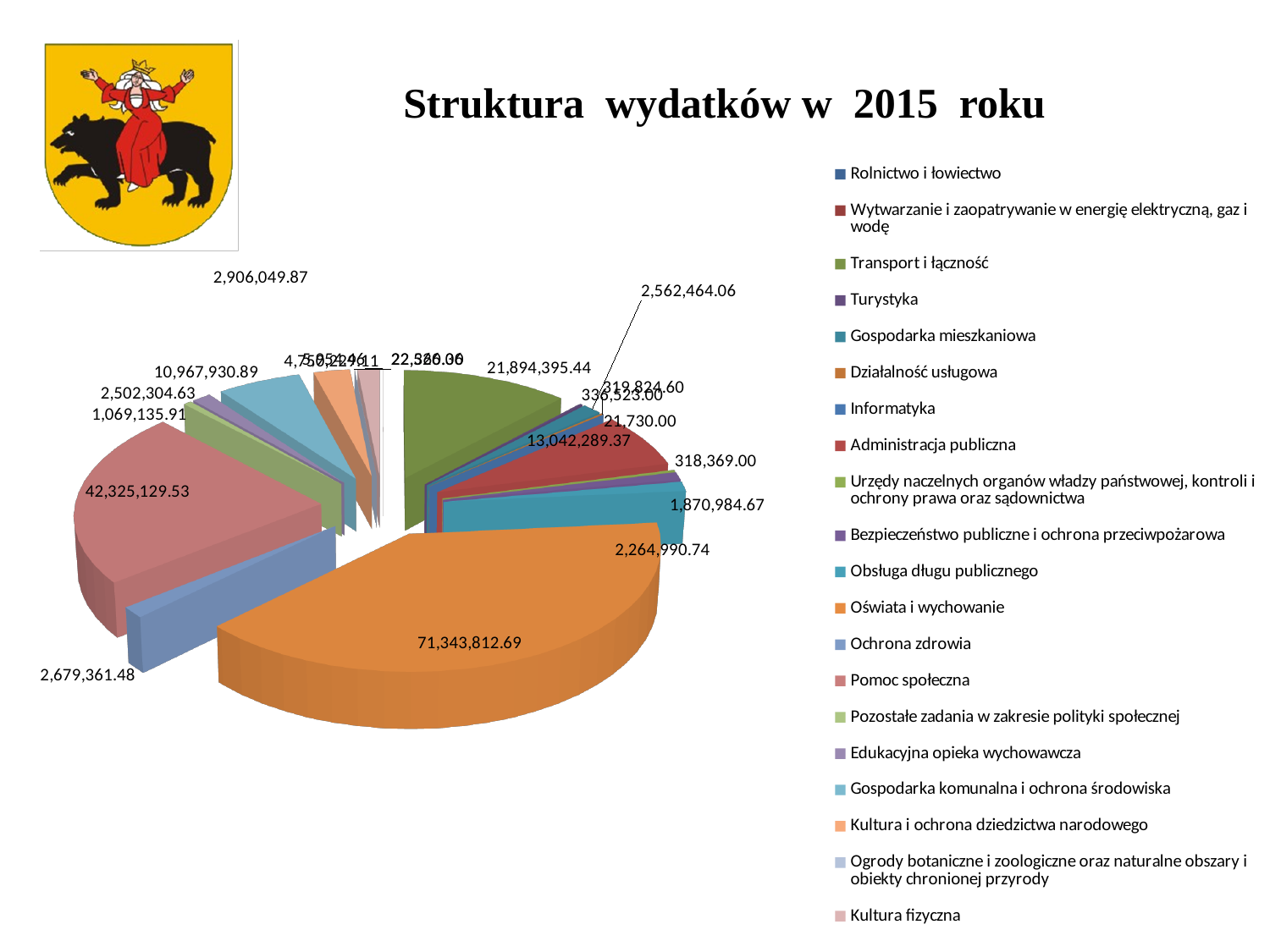
What is the difference between the values for Oświata i wychowanie and Pomoc społeczna? 29,018,683.16 What is the value shown for Administracja publiczna? 13,042,289.37 Which is larger, the slice for Oświata i wychowanie or the slice for Pomoc społeczna? Oświata i wychowanie What is the value of the largest slice of the pie? 71,343,812.69 What is the value shown for Transport i łączność? 21,894,395.44 Which is larger, the slice for Transport i łączność or the slice for Administracja publiczna? Transport i łączność What is the value shown for Gospodarka komunalna i ochrona środowiska? 10,967,930.89 What is the value shown for Pomoc społeczna? 42,325,129.53 Which category has the largest slice of the pie? Oświata i wychowanie What is the title of the chart? Struktura wydatków w 2015 roku What kind of chart is shown on the slide? pie chart How many categories does the legend list? 20